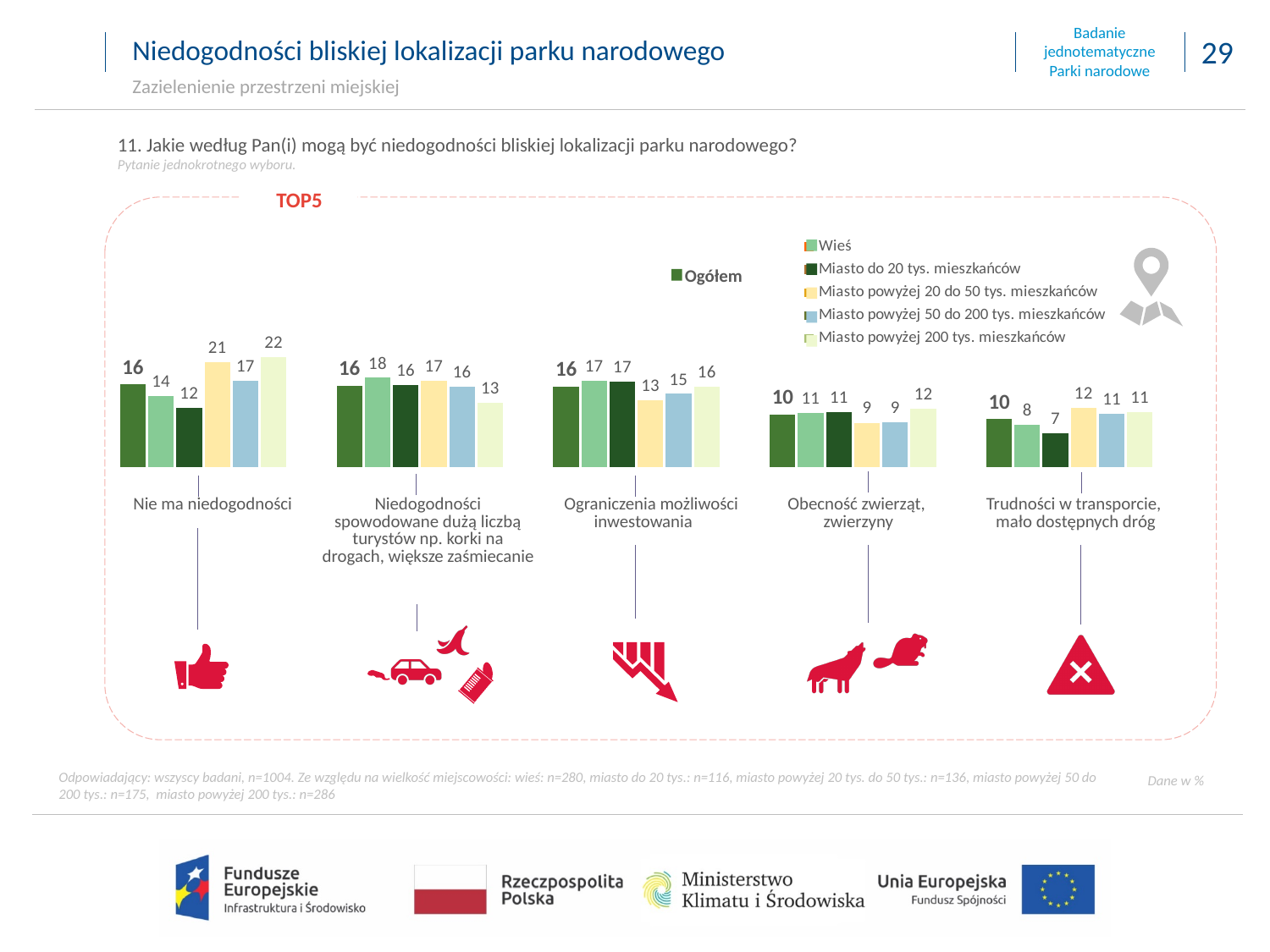
Which category has the lowest Ogółem value? Obecność zwierząt, zwierzyny and Trudności w transporcie, mało dostępnych dróg (both 10) Within the "Nie ma niedogodności" category, which series has the highest value? Miasto powyżej 200 tys. mieszkańców What is the value for "Miasto do 20 tys. mieszkańców" in the "Trudności w transporcie, mało dostępnych dróg" category? 7 What is the label shown above the chart area in red? TOP5 What is the difference between the "Miasto powyżej 200 tys. mieszkańców" value and the "Miasto do 20 tys. mieszkańców" value in the "Nie ma niedogodności" category? 10 What is the value for "Miasto powyżej 200 tys. mieszkańców" in the "Nie ma niedogodności" category? 22 What type of chart is shown on the slide? Bar chart What is the value for "Wieś" in the "Niedogodności spowodowane dużą liczbą turystów" category? 18 How many categories are shown in the chart? 5 How many series does the chart's legend list in total (including Ogółem)? 6 What is the Ogółem value for "Nie ma niedogodności"? 16 In the "Obecność zwierząt, zwierzyny" category, which is larger: the value for "Wieś" or for "Miasto powyżej 20 do 50 tys. mieszkańców"? Wieś